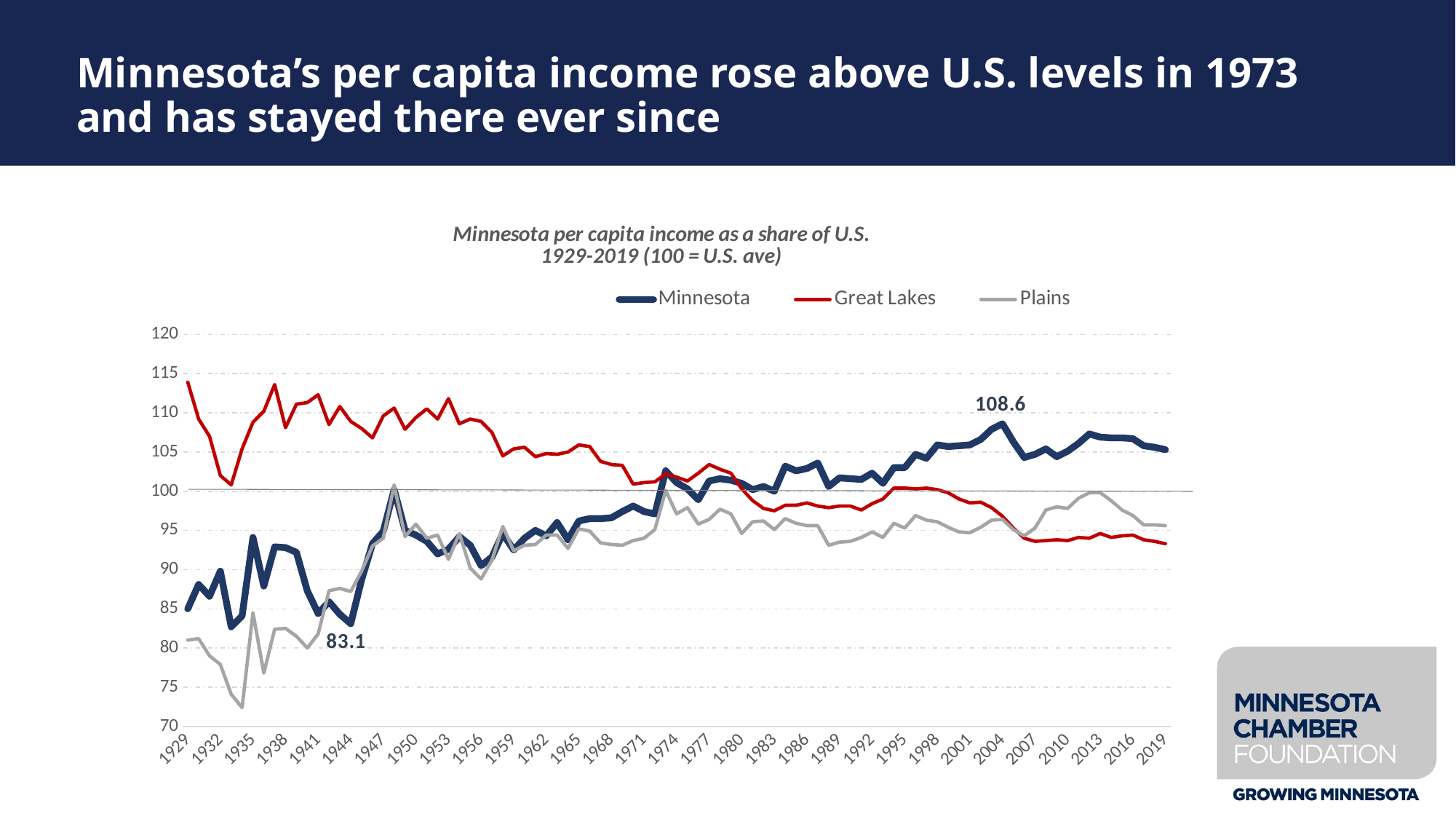
Is the Great Lakes value in 1929 greater or less than 110? greater What is the difference between the two labeled Minnesota values, 108.6 and 83.1? 25.5 Is the lowest point of the Plains line greater or less than 75? less Does the Great Lakes line overall rise or fall from 1929 to 2019? Fall Which series has the highest value in 1929? Great Lakes Is the Minnesota value in 2019 greater or less than 100? greater What is the low value labeled on the Minnesota line in the 1940s? 83.1 What kind of chart is shown on the slide? Line chart What colour is the Minnesota line in the chart? Dark blue In 2019, which series is higher: Minnesota or Great Lakes? Minnesota What is the peak value labeled on the Minnesota line? 108.6 How many series does the chart's legend list? 3